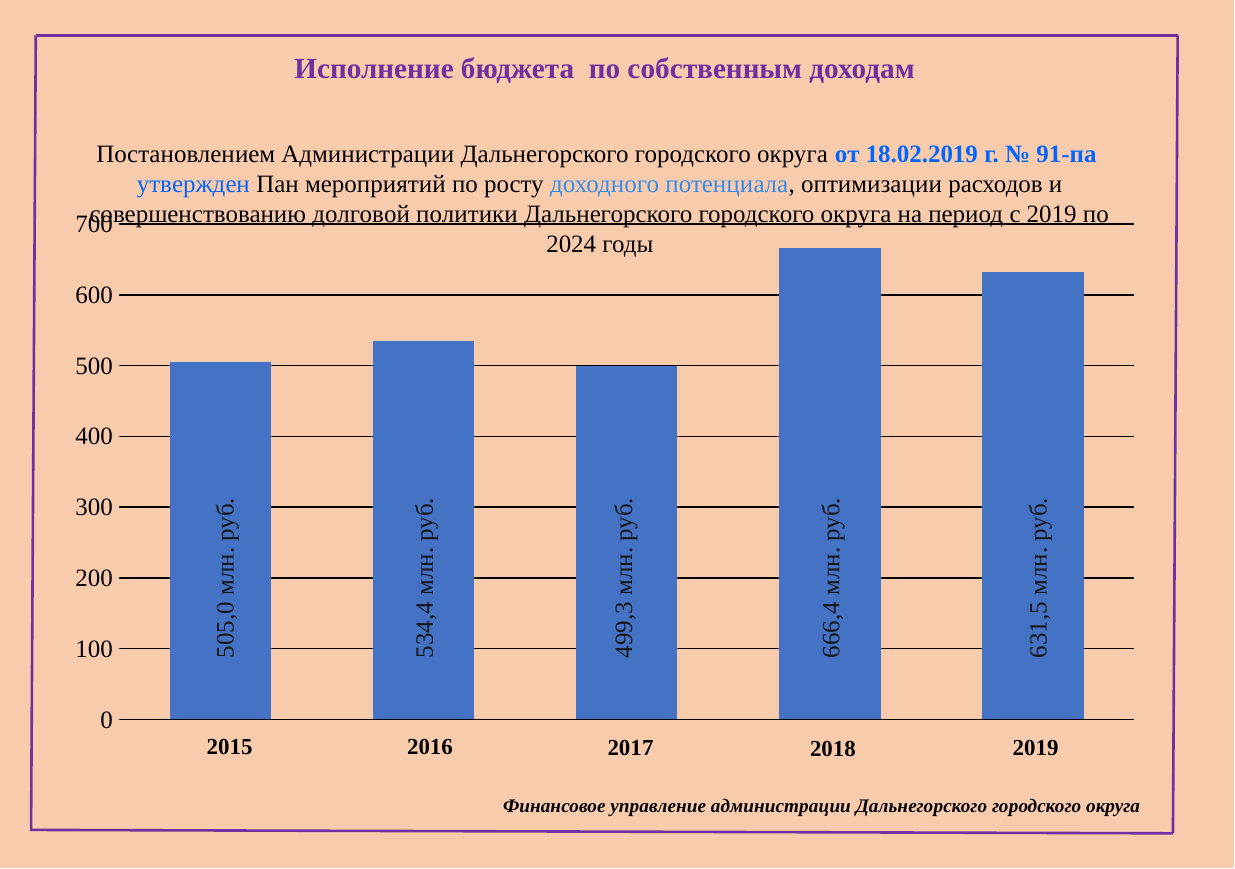
What is the value for 2017? 499,3 млн. руб. What is the value for 2015? 505,0 млн. руб. Which is larger, the value for 2016 or the value for 2017? 2016 What is the value for 2018? 666,4 млн. руб. What is the difference between the values for 2016 and 2015? 29,4 млн. руб. Which year has the highest value? 2018 How many years are shown on the x axis? 5 Which year has the lowest value? 2017 What kind of chart is shown on the slide? bar chart Is the value for 2019 greater or less than 600? greater What is the difference between the values for 2018 and 2019? 34,9 млн. руб. What is the title of the slide? Исполнение бюджета по собственным доходам